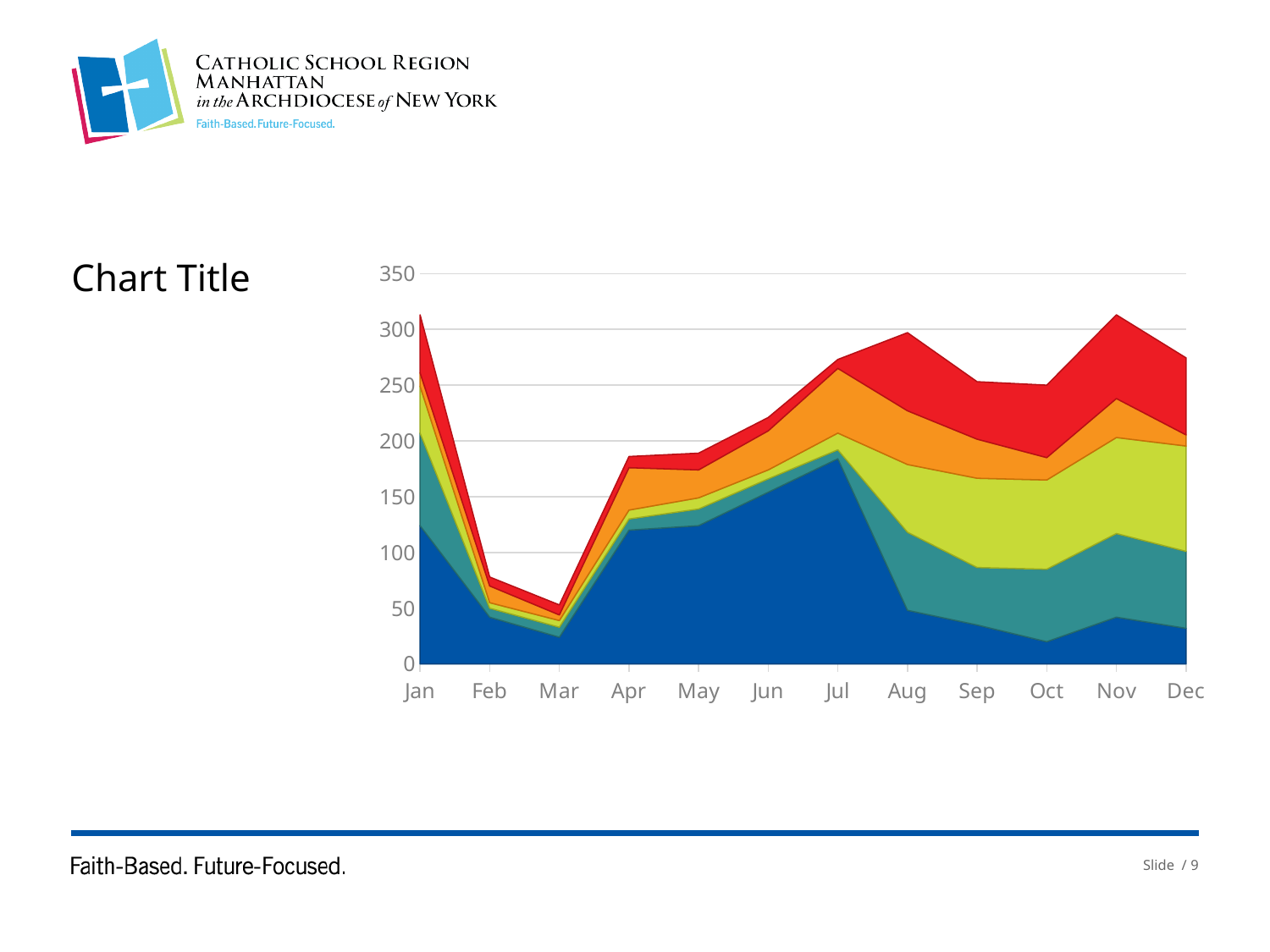
Which month has the larger total, Jul or Apr? Jul Which month has the lowest total (top of the stacked areas)? Mar Does the total value rise or fall from Jan to Mar? Fall What kind of chart is shown on the slide? Stacked area chart Which month has the larger total, Aug or Sep? Aug How many coloured areas (series) are stacked in the chart? 5 Is the total value for Mar greater or less than 100? less How many months are shown along the x axis of the chart? 12 Is the total value for Aug greater or less than 250? greater What is the title of the chart? Chart Title Is the total value for Apr greater or less than 200? less